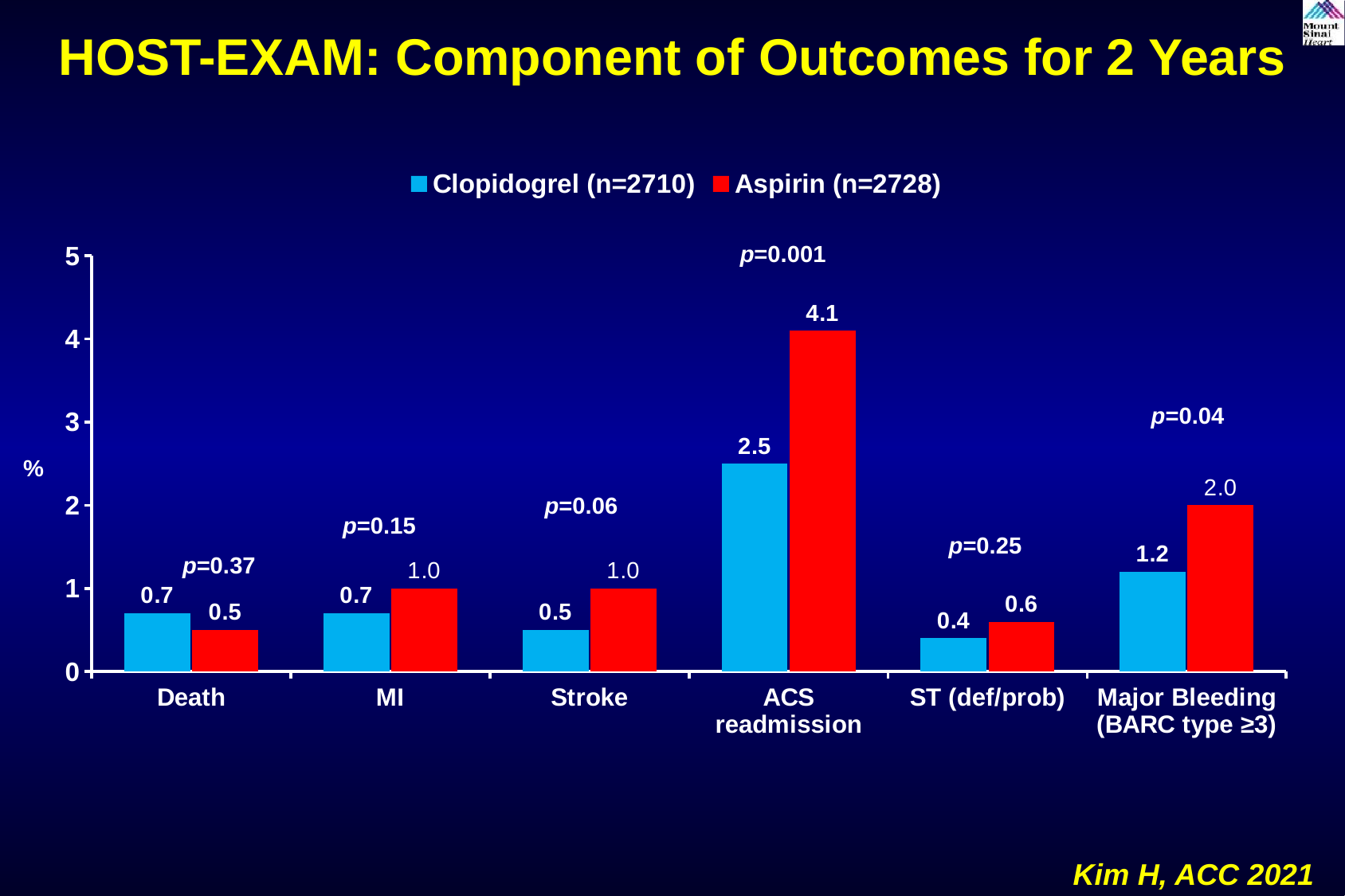
How many outcome categories are shown on the x axis? 6 What p-value is shown above the Major Bleeding (BARC type ≥3) bars? p=0.04 What kind of chart is shown on the slide? bar chart What is the difference between the Aspirin and Clopidogrel values for ACS readmission? 1.6 What is the Aspirin value for ACS readmission? 4.1 Which outcome has the lowest Clopidogrel value? ST (def/prob) What is the Clopidogrel value for Major Bleeding (BARC type ≥3)? 1.2 How many series does the legend list? 2 Which is larger for Death: the Clopidogrel value or the Aspirin value? Clopidogrel Which outcome has the highest Aspirin value? ACS readmission What is the Clopidogrel value for Death? 0.7 Is the Aspirin value for ACS readmission greater or less than 4? greater